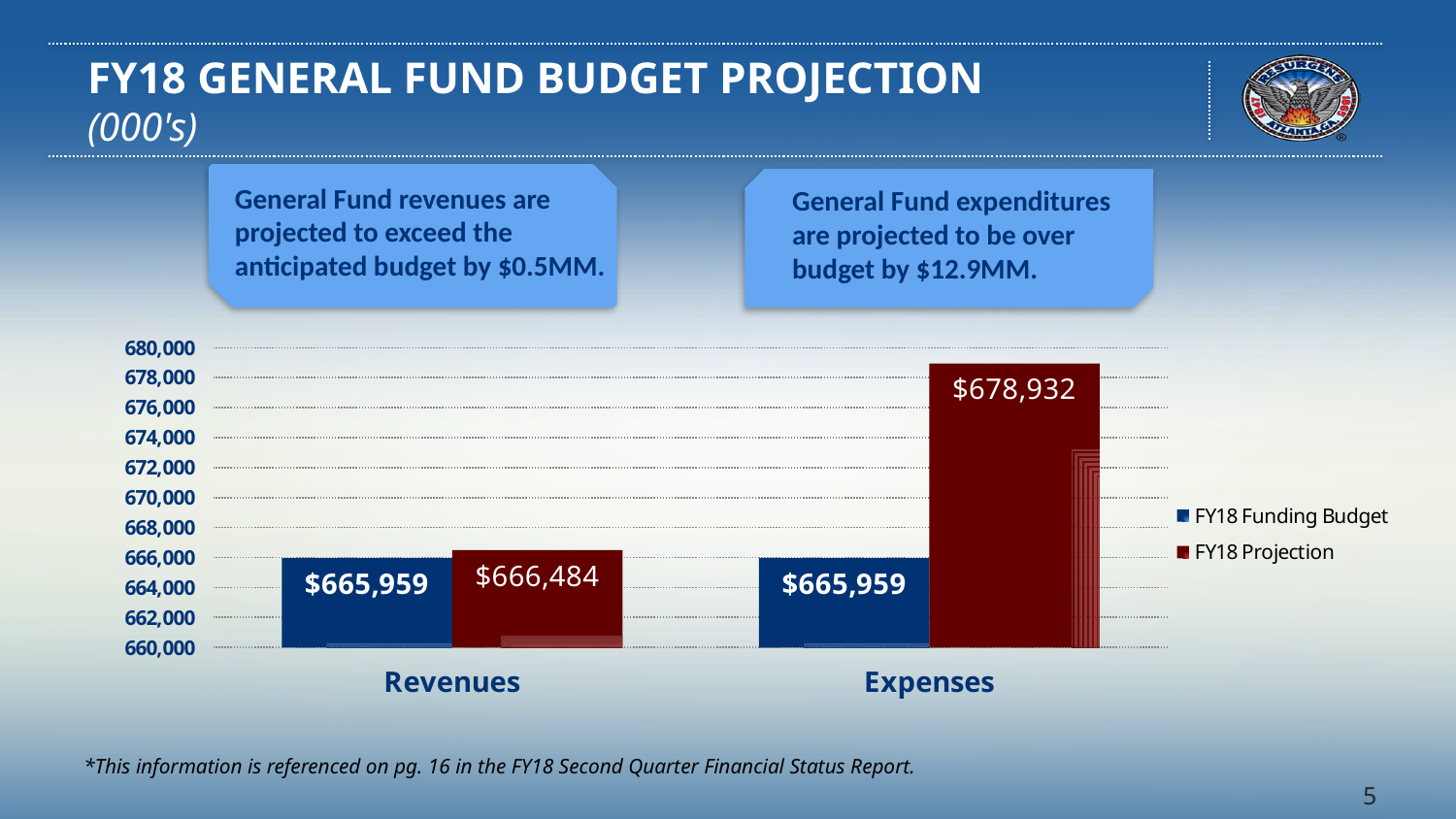
What is the FY18 Funding Budget value for Expenses? $665,959 What is the FY18 Projection value for Expenses? $678,932 Which is larger for Revenues, the FY18 Funding Budget or the FY18 Projection? FY18 Projection What is the FY18 Funding Budget value for Revenues? $665,959 What is the difference between the FY18 Projection and the FY18 Funding Budget for Revenues? $525 Is the FY18 Projection value for Expenses greater or less than 676,000? greater How many categories are shown on the x axis of the chart? 2 How many series does the chart legend list? 2 What type of chart is shown on the slide? Bar chart What is the difference between the FY18 Projection and the FY18 Funding Budget for Expenses? $12,973 What is the FY18 Projection value for Revenues? $666,484 Which bar on the chart has the highest value? FY18 Projection for Expenses